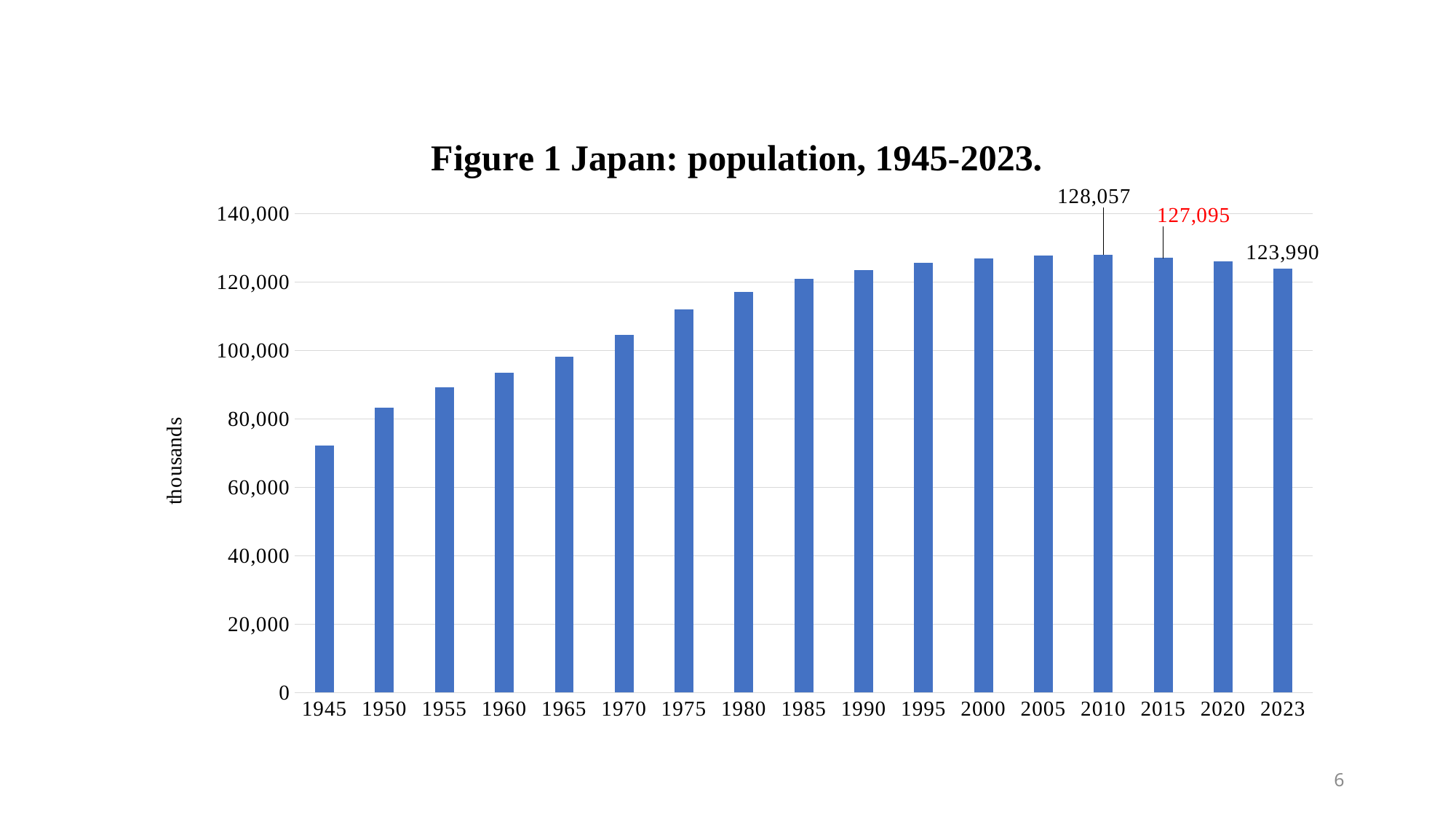
What is the value for 2015? 127,095 Is the value for 1980 greater or less than 120,000? less What is the difference between the values for 2015 and 2023? 3,105 What is the difference between the values for 2010 and 2015? 962 What kind of chart is this? bar chart What is the value for 2023? 123,990 Is the value for 1970 greater or less than 100,000? greater What is the value for 2010? 128,057 Which is larger, the value for 2010 or the value for 2023? 2010 Is the value for 1945 greater or less than 80,000? less Which year has the lowest population? 1945 How many years are shown on the x axis? 17